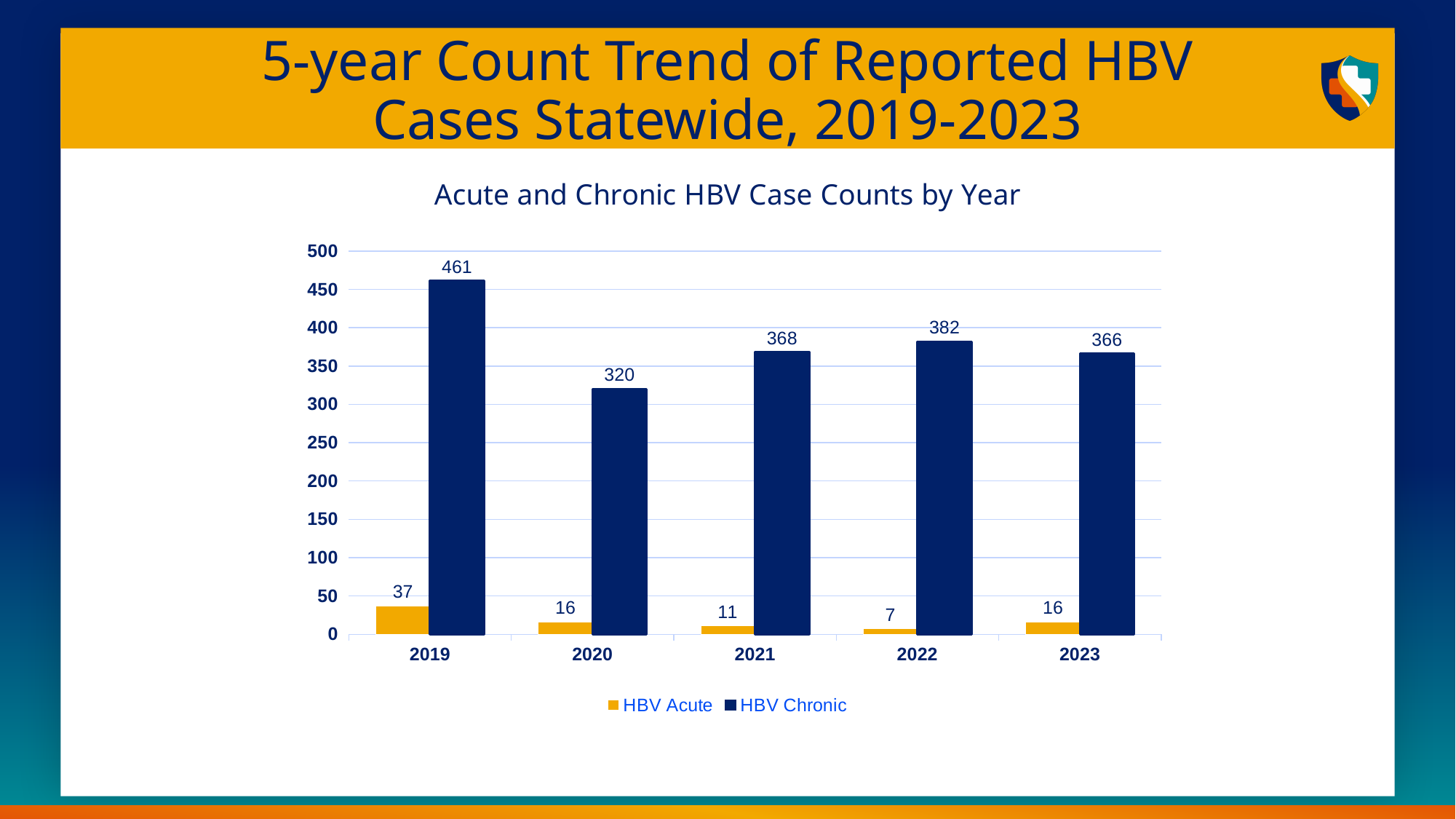
What is the title of the chart? Acute and Chronic HBV Case Counts by Year What kind of chart is shown on the slide? bar chart Which year has the highest HBV Chronic case count? 2019 How many years are shown on the x axis? 5 Which is larger, the HBV Chronic count for 2021 or for 2022? 2022 What is the difference between the HBV Chronic counts for 2019 and 2020? 141 What is the HBV Acute case count for 2022? 7 What is the HBV Chronic case count for 2023? 366 How many series does the legend list? 2 Is the HBV Chronic value for 2020 greater or less than 350? less What is the HBV Chronic case count for 2019? 461 Which year has the lowest HBV Acute case count? 2022